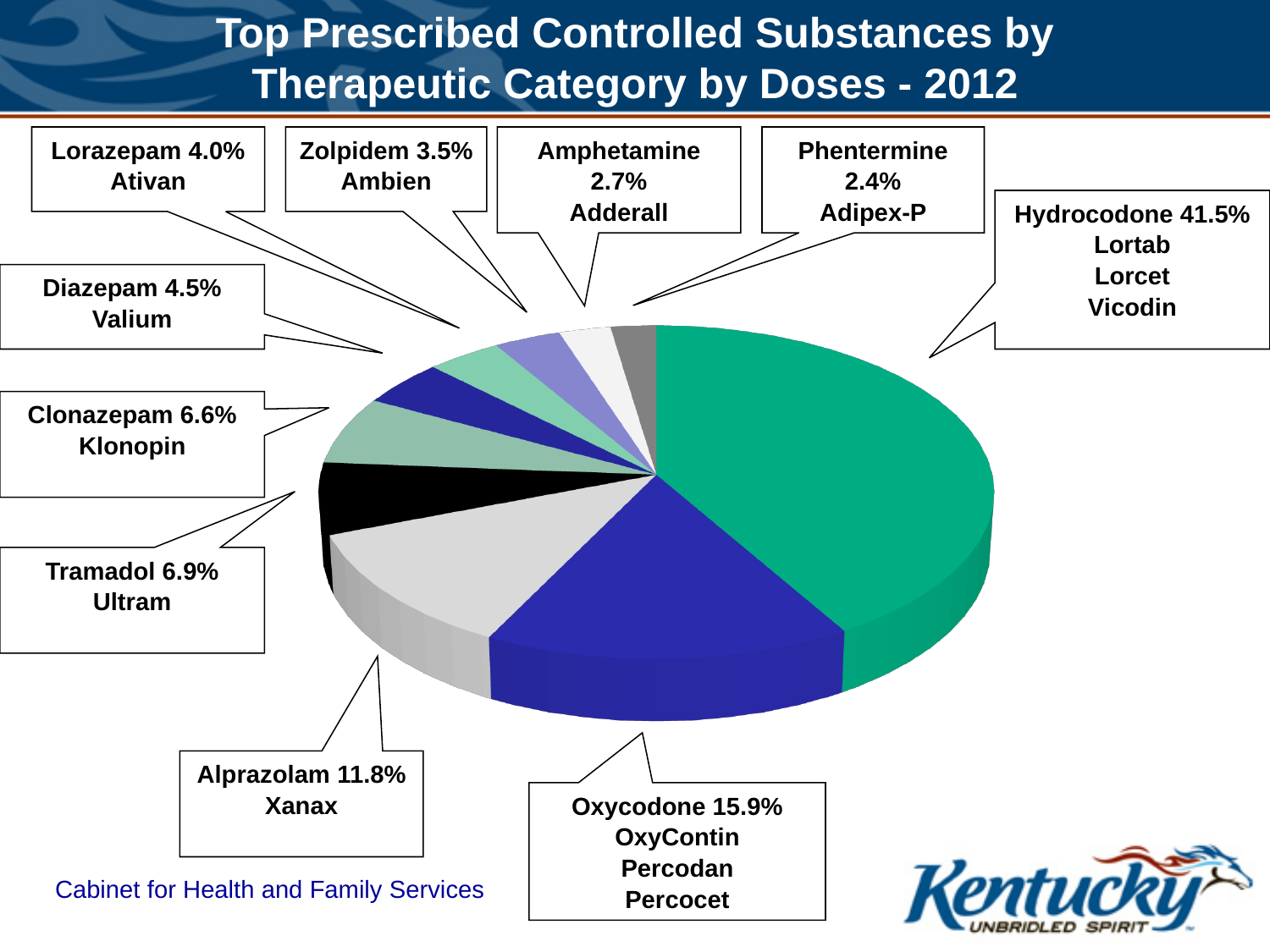
What is the title of the chart? Top Prescribed Controlled Substances by Therapeutic Category by Doses - 2012 Which has a larger share, Clonazepam or Diazepam? Clonazepam What percentage is shown for Tramadol (Ultram)? 6.9% What brand name is listed under Zolpidem? Ambien How many substances are labeled on the pie chart? 10 Which substance has the smallest share of the pie? Phentermine What percentage is shown for Alprazolam (Xanax)? 11.8% What is the difference in percentage points between Hydrocodone and Oxycodone? 25.6 What percentage of doses does Hydrocodone account for? 41.5% What percentage is shown for Oxycodone? 15.9% What kind of chart is shown on the slide? Pie chart Which substance has the largest share of the pie? Hydrocodone